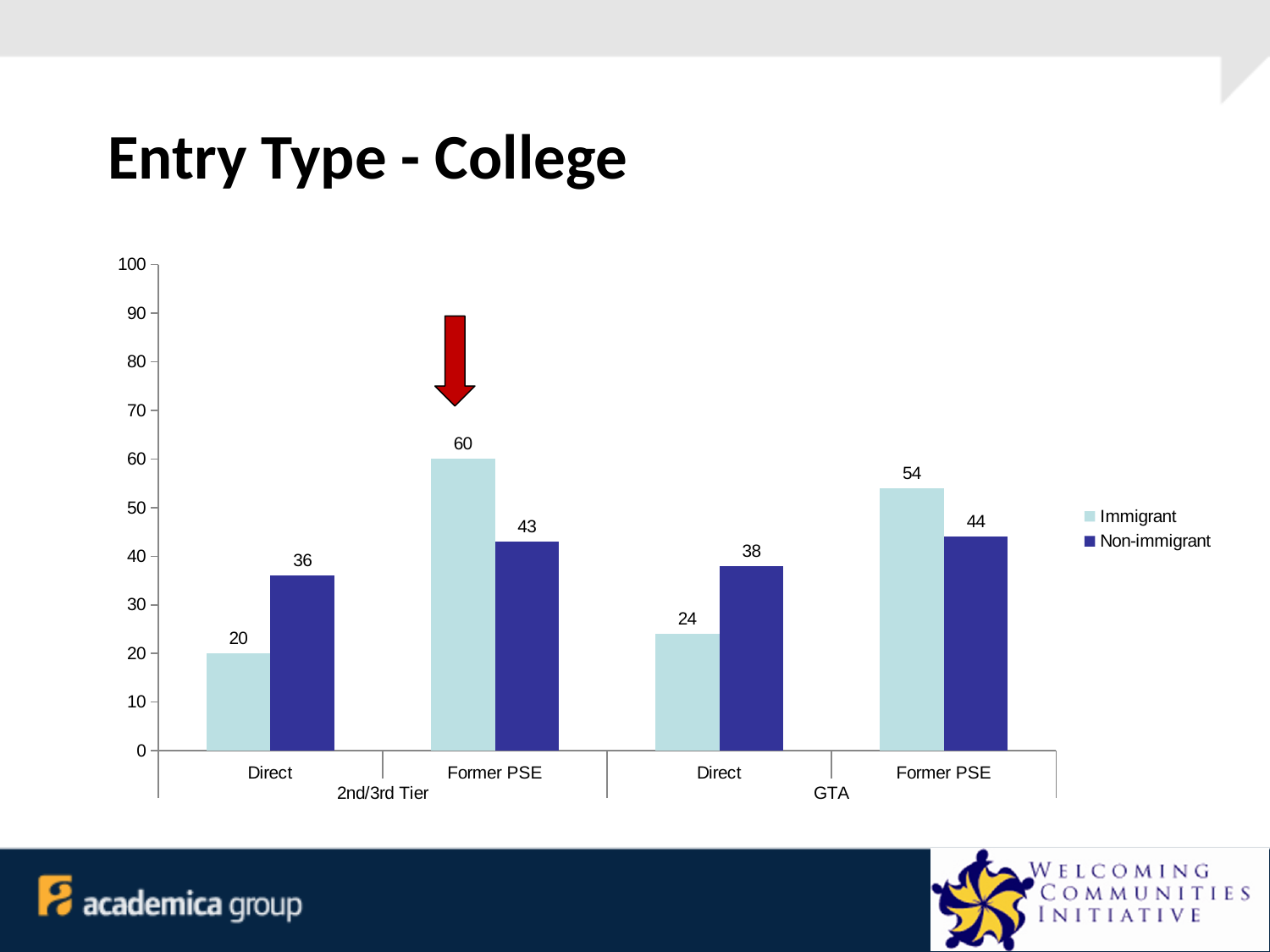
What is the difference between the Immigrant and Non-immigrant values for Former PSE in the 2nd/3rd Tier group? 17 Which bar has the lowest value on the chart? Immigrant, Direct, 2nd/3rd Tier What is the Immigrant value for Direct in the 2nd/3rd Tier group? 20 What is the Non-immigrant value for Former PSE in the GTA group? 44 Which bar has the highest value on the chart? Immigrant, Former PSE, 2nd/3rd Tier What is the title of the slide? Entry Type - College What is the Immigrant value for Former PSE in the 2nd/3rd Tier group? 60 What is the Non-immigrant value for Direct in the GTA group? 38 What kind of chart is shown on the slide? Bar chart How many series does the legend list? 2 For Direct in the GTA group, which is larger: the Immigrant value or the Non-immigrant value? Non-immigrant What is the difference between the Non-immigrant values for Direct in the 2nd/3rd Tier group and Direct in the GTA group? 2